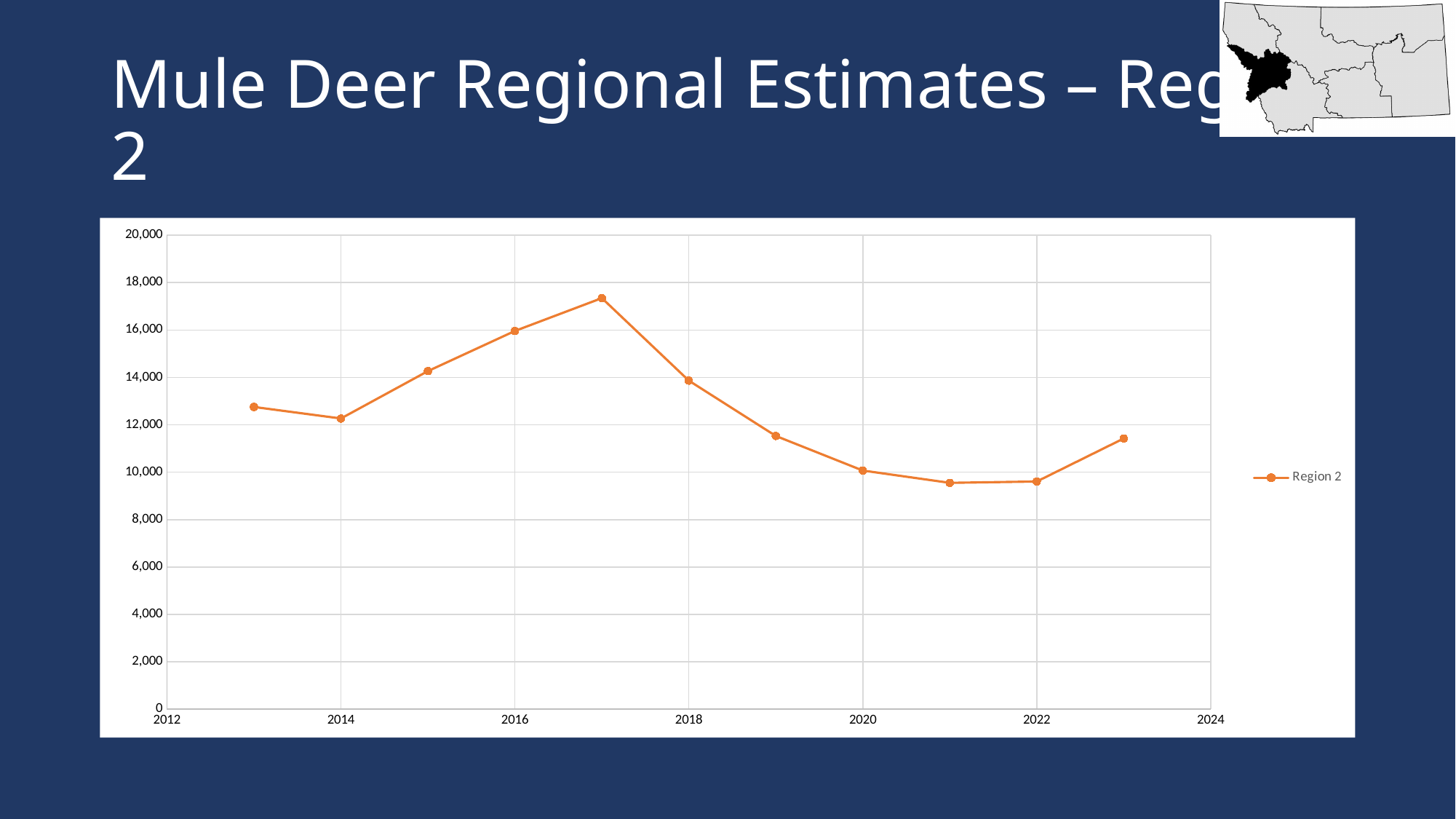
Is the value for 2019 greater or less than 12,000? less Is the value for 2017 greater or less than 16,000? greater Is the value for 2023 greater or less than 10,000? greater Do the values rise or fall from 2014 to 2017? rise In which year is the Region 2 estimate highest? 2017 How many series does the legend list? 1 Which year has the larger value, 2016 or 2018? 2016 Do the values rise or fall from 2017 to 2021? fall What is the name of the series shown in the legend? Region 2 How many data points are plotted on the line? 11 What kind of chart is shown on the slide? line chart